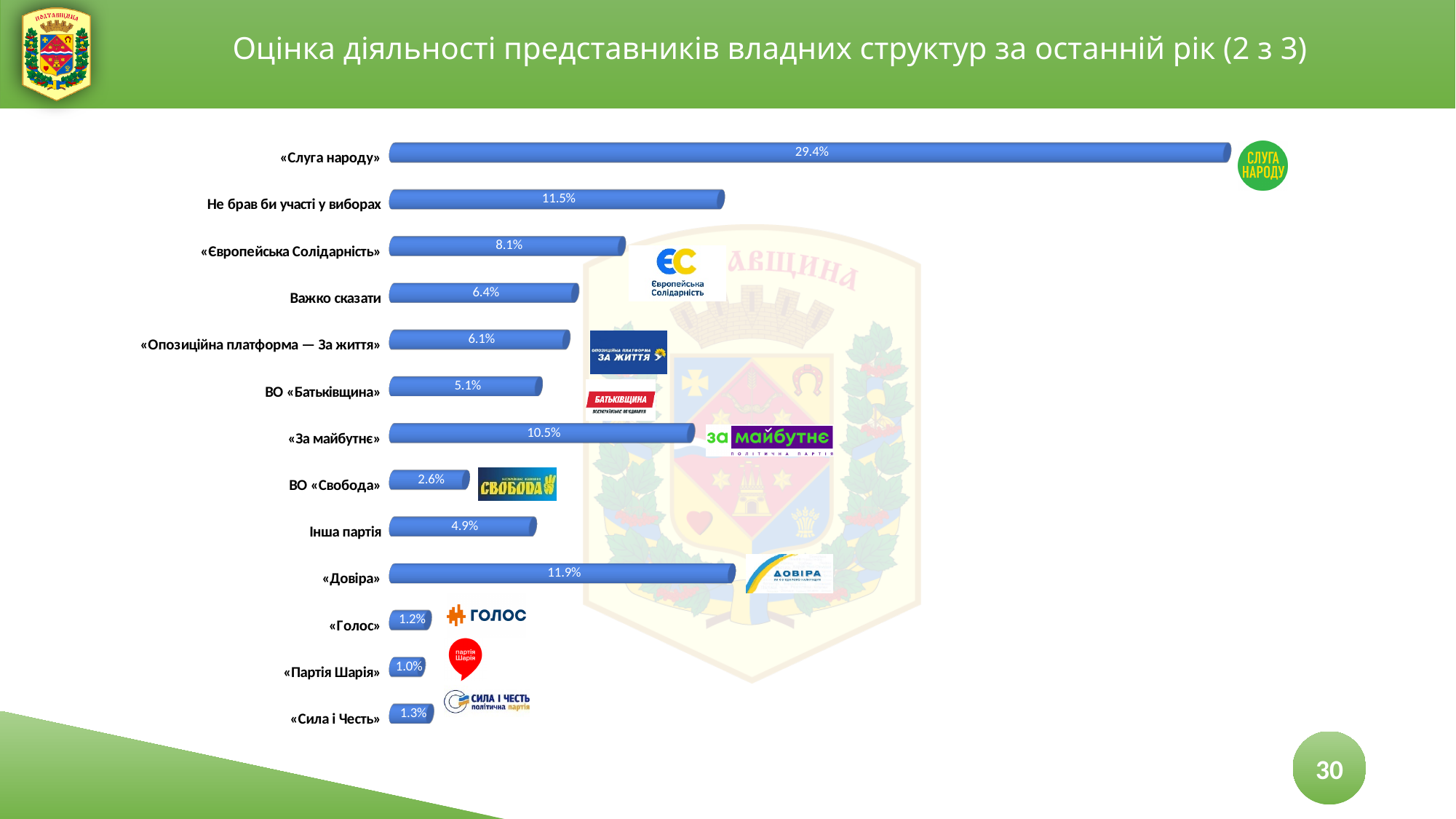
Which is larger, the value for «Голос» or the value for «Сила і Честь»? «Сила і Честь» What value is shown for «За майбутнє»? 10.5% What value is shown for «Довіра»? 11.9% Which category has the highest value? «Слуга народу» Which category has the lowest value? «Партія Шарія» What is the difference between the values for «Європейська Солідарність» and ВО «Свобода»? 5.5% Which is larger, the value for «Довіра» or the value for Не брав би участі у виборах? «Довіра» What value is shown for ВО «Батьківщина»? 5.1% What is the difference between the values for «Слуга народу» and «Довіра»? 17.5% What value is shown for «Слуга народу»? 29.4% What kind of chart is shown on the slide? Bar chart How many categories are shown in the chart? 13